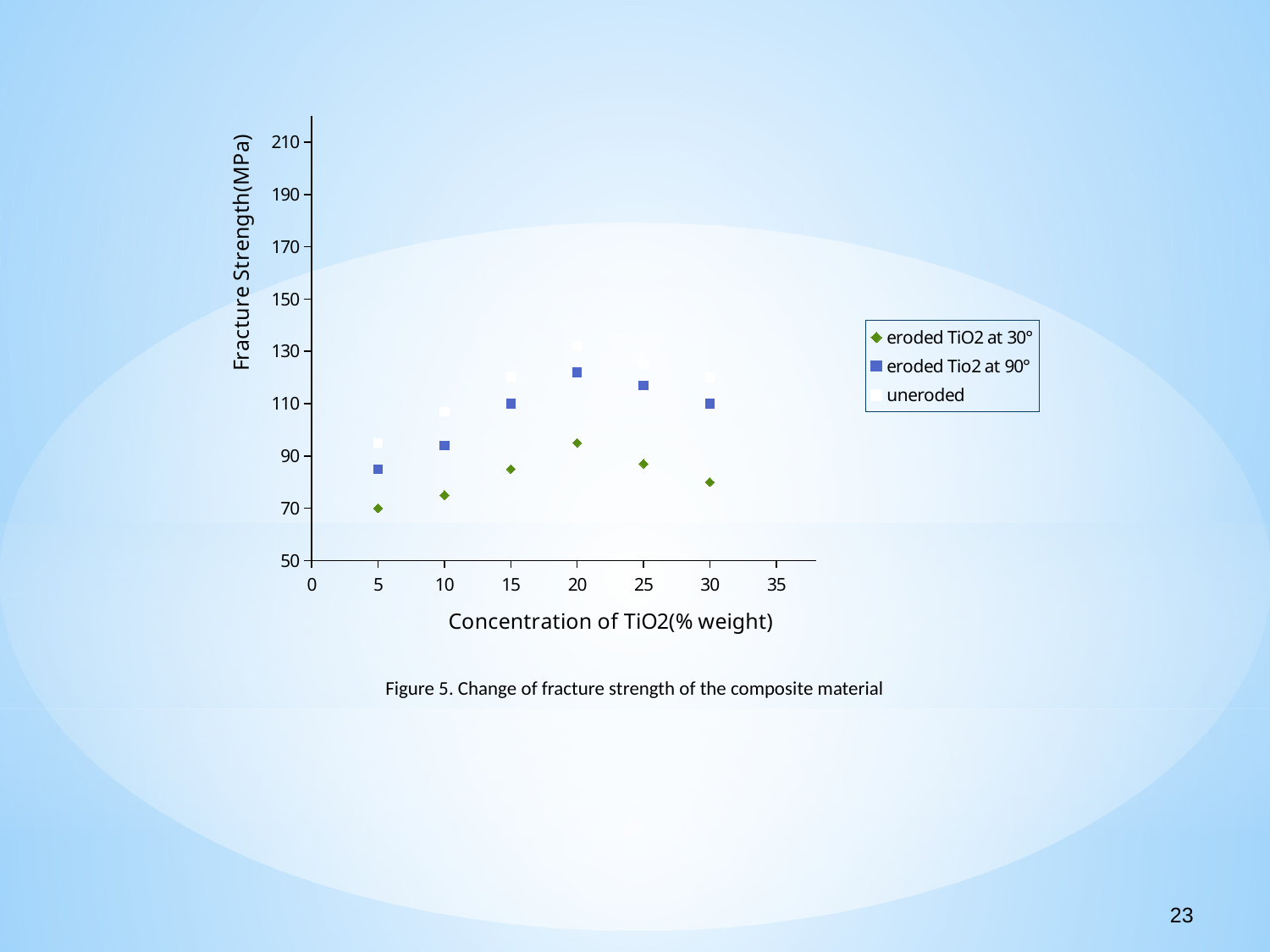
At a TiO2 concentration of 20, which series has the higher fracture strength: 'uneroded' or 'eroded TiO2 at 30°'? uneroded What kind of chart is shown on the slide? scatter chart Is the fracture strength for 'eroded Tio2 at 90°' at a concentration of 5 greater or less than 90? less At which TiO2 concentration does the 'uneroded' series have its lowest fracture strength? 5 How many series does the legend list? 3 How many data points are plotted for the 'eroded TiO2 at 30°' series? 6 What is the fracture strength for 'eroded TiO2 at 30°' at a TiO2 concentration of 5? 70 Does the fracture strength of the 'uneroded' series rise or fall between concentrations 20 and 30? fall At which TiO2 concentration does the 'eroded TiO2 at 30°' series reach its highest fracture strength? 20 What is the fracture strength for 'eroded Tio2 at 90°' at a TiO2 concentration of 15? 110 What is the title of the y axis? Fracture Strength(MPa)